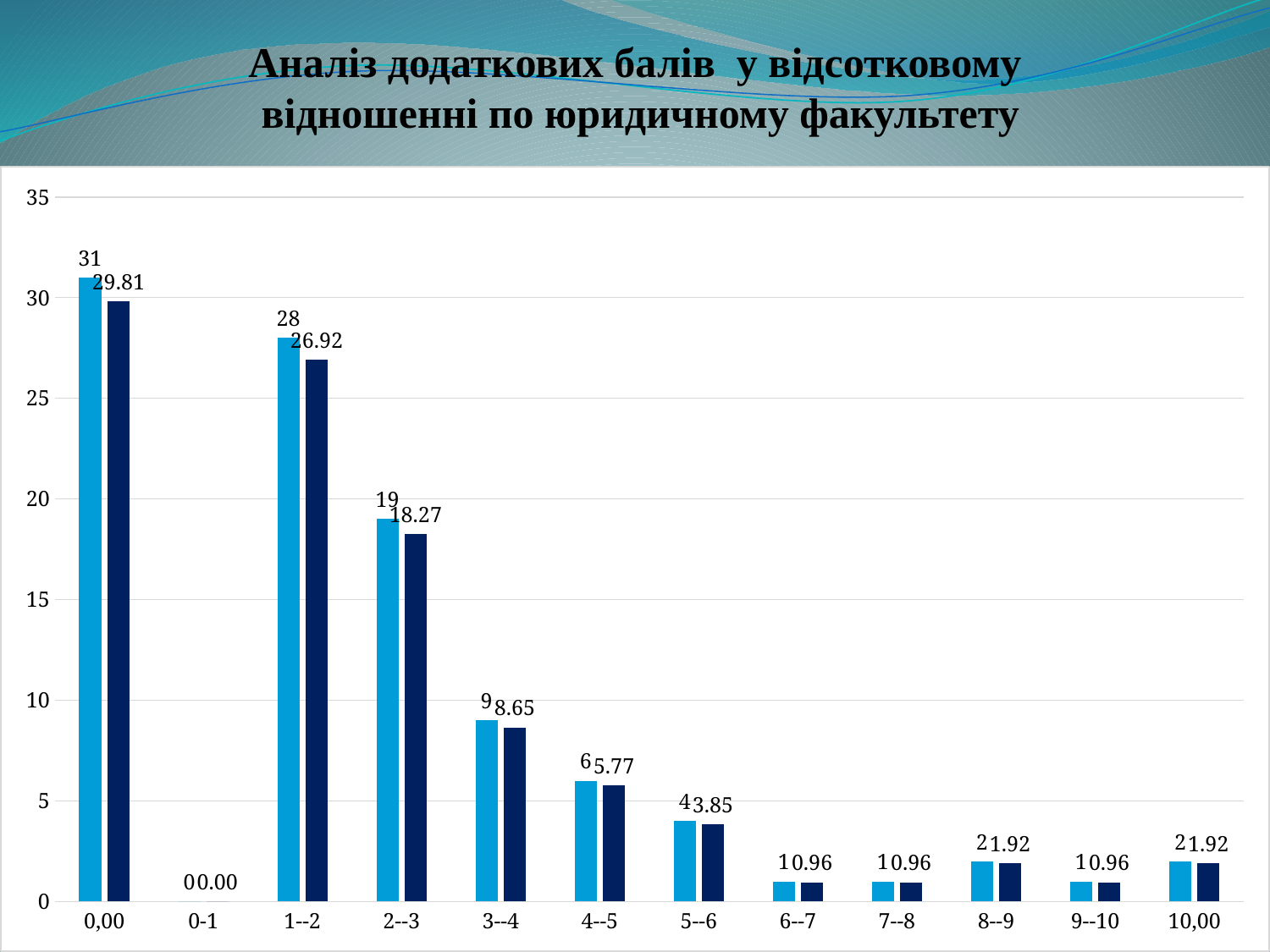
What is the value of the dark blue bar for the category 1--2? 26.92 Which is larger: the dark blue bar for 4--5 or the dark blue bar for 5--6? 4--5 Which category has the lowest dark blue bar? 0-1 How many categories are shown on the x axis of the chart? 12 What is the title of the chart on the slide? Аналіз додаткових балів у відсотковому відношенні по юридичному факультету What is the value of the light blue bar for the category 3--4? 9 What kind of chart is shown on the slide? bar chart What is the value of the light blue bar for the category 0,00? 31 Is the value of the dark blue bar for 0,00 greater or less than 25? greater What is the difference between the light blue bars for 1--2 and 2--3? 9 Which category has the highest light blue bar? 0,00 What is the value of the dark blue bar for the category 2--3? 18.27